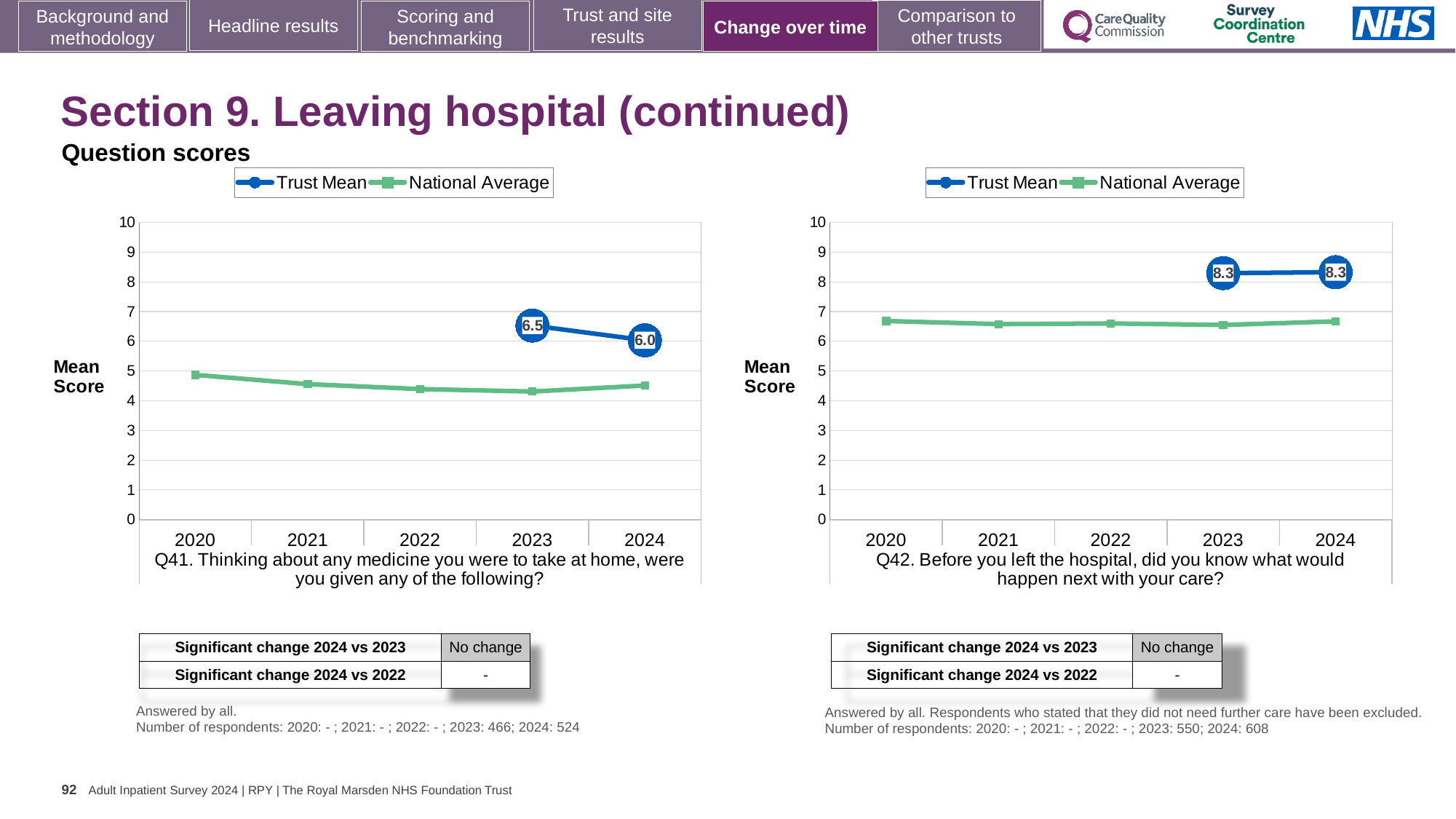
In the Q42 chart, is the Trust Mean for 2024 higher or lower than the National Average for 2024? higher How many series does the legend of the Q41 chart list? 2 In the Q41 chart, does the Trust Mean rise or fall from 2023 to 2024? fall In the Q41 chart, is the National Average value for 2020 greater or less than 6? less In the Q41 chart, which series is shown in green? National Average In the Q41 chart, what is the Trust Mean value for 2023? 6.5 How many years are shown on the x axis of the Q42 chart? 5 In the Q42 chart, what is the Trust Mean value for 2024? 8.3 In the Q41 chart, what is the Trust Mean value for 2024? 6.0 In the Q42 chart, is the National Average value for 2023 greater or less than 6? greater What type of chart is used for Q42? line chart In the Q41 chart, what is the difference between the Trust Mean values for 2023 and 2024? 0.5